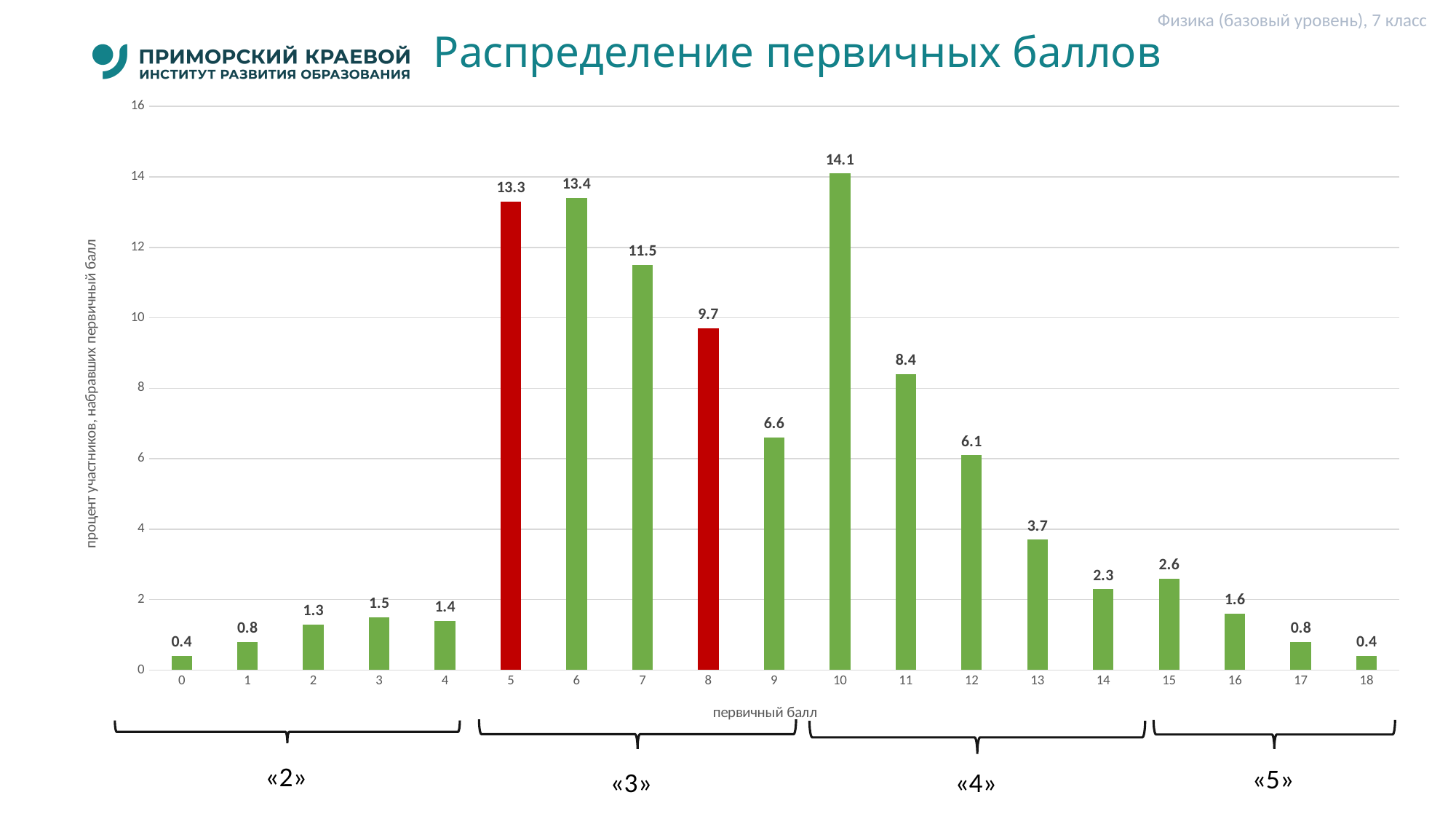
Do the values rise or fall along the x axis from primary score 10 to 14? fall Which is larger, the value for primary score 8 or the value for primary score 11? 8 What is the title of the chart? Распределение первичных баллов What kind of chart is shown on the slide? bar chart What is the value for primary score 13? 3.7 What is the value for primary score 10? 14.1 Is the value for primary score 9 greater or less than 6? greater What is the difference between the values for primary scores 6 and 7? 1.9 What is the value for primary score 5? 13.3 Which primary score has the highest percentage of participants? 10 How many primary score categories are shown on the x axis? 19 Which primary scores are shown with red bars? 5 and 8